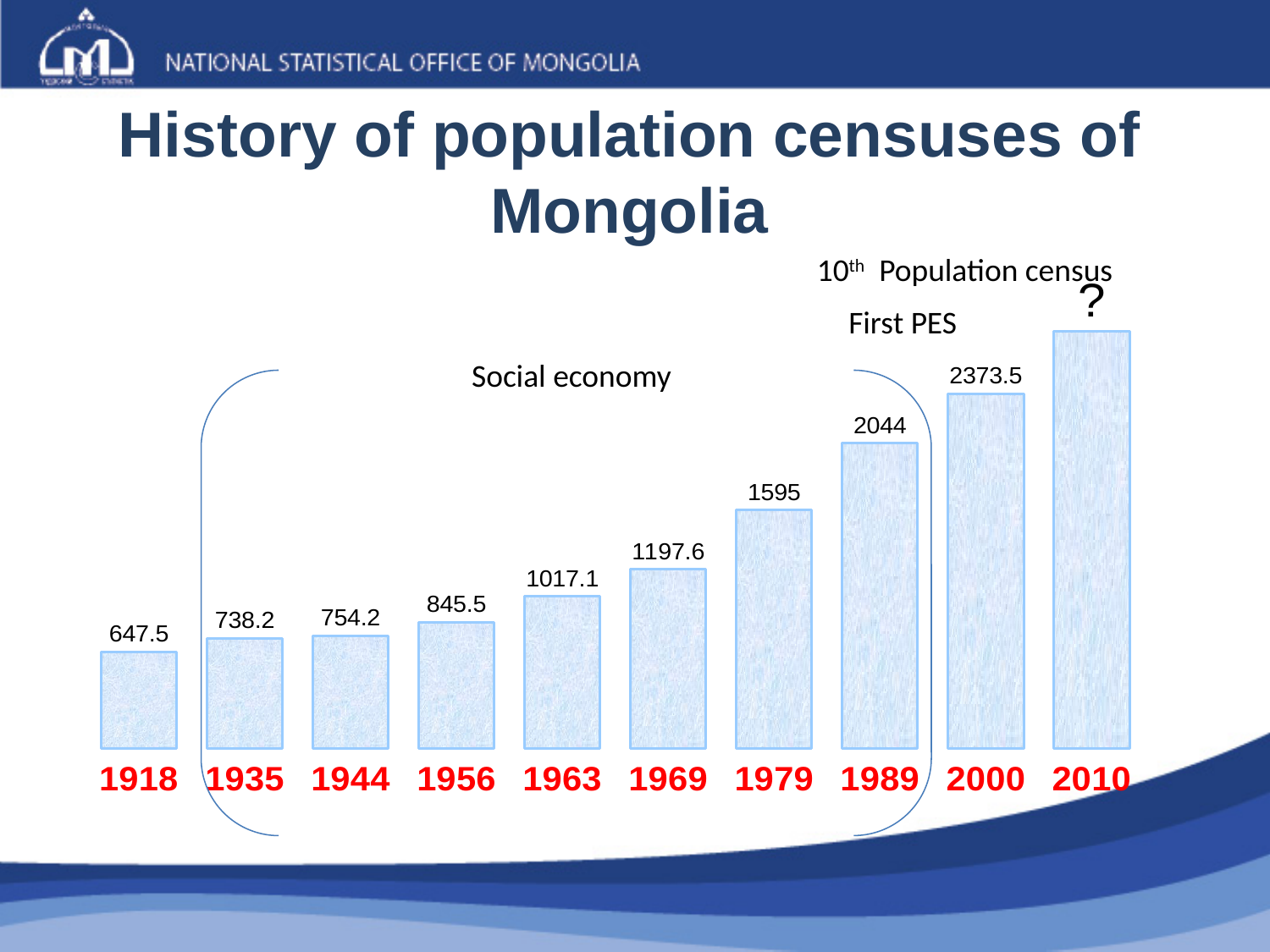
Which year has the lowest value? 1918 What is the value shown for 2000? 2373.5 How many years (bars) are shown in the chart? 10 What is the value shown for 1918? 647.5 Which year has the tallest bar? 2010 What kind of chart is shown on the slide? Bar chart What is the difference between the values for 1979 and 1969? 397.4 What is the value shown for 1963? 1017.1 Which is larger, the value for 1956 or the value for 1944? 1956 What is the difference between the values for 2000 and 1989? 329.5 Do the values rise or fall from 1918 to 2000? Rise What is the value shown for 1989? 2044